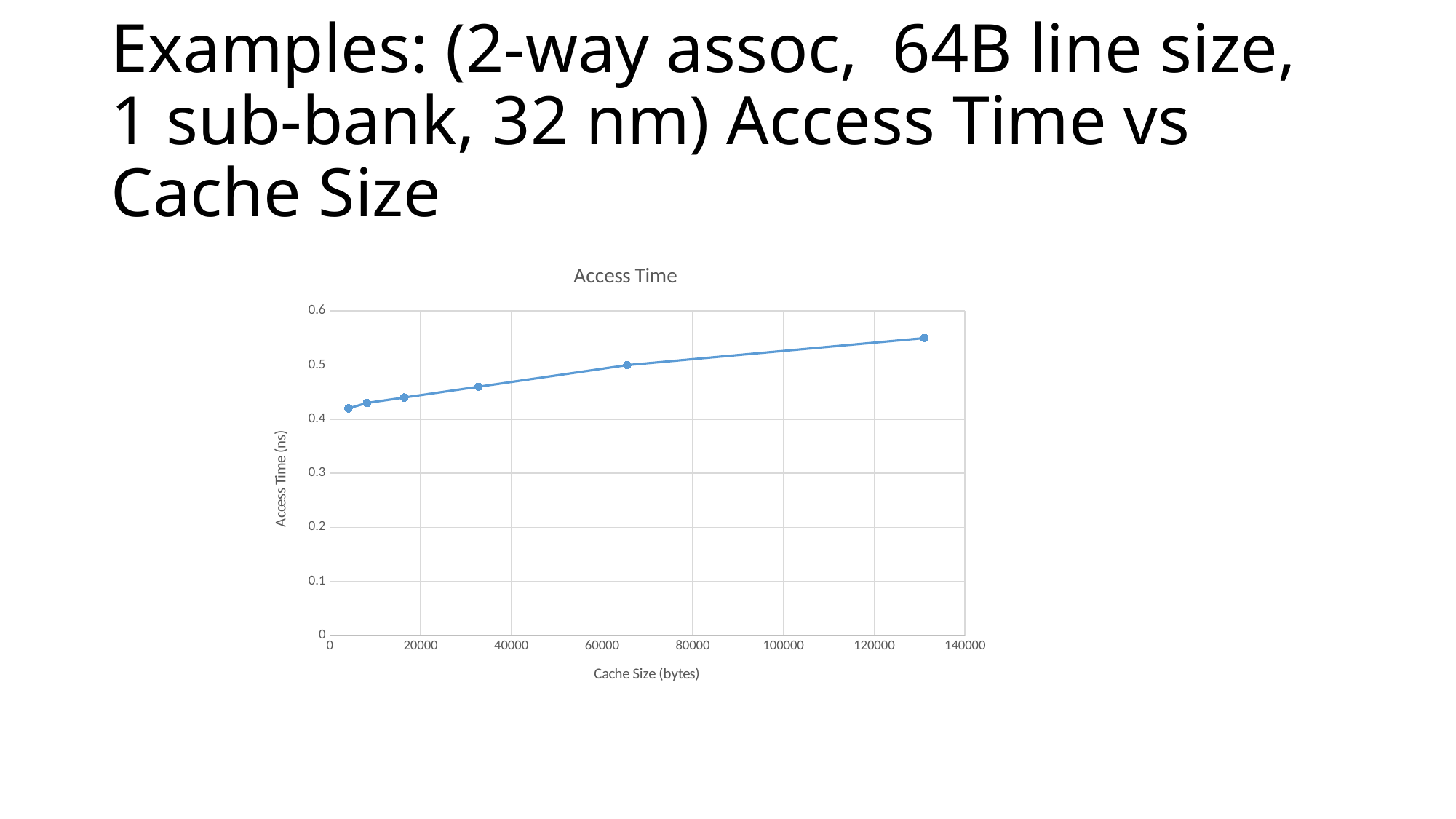
Is the access time for the smallest cache size plotted greater or less than 0.5? less Is the access time for the cache size of about 33000 bytes greater or less than 0.4? greater Is the access time for the largest cache size plotted (around 131000 bytes) greater or less than 0.5? greater What is the label of the y axis? Access Time (ns) What is the title of the chart? Access Time Which is larger: the access time at about 65000 bytes or the access time at about 16000 bytes? about 65000 bytes What kind of chart is shown on the slide? line chart How many data points are plotted on the line? 6 Does access time rise or fall as cache size increases along the x axis? rises Which plotted point has the highest access time: the one at the smallest cache size or the one at the largest cache size? the largest cache size